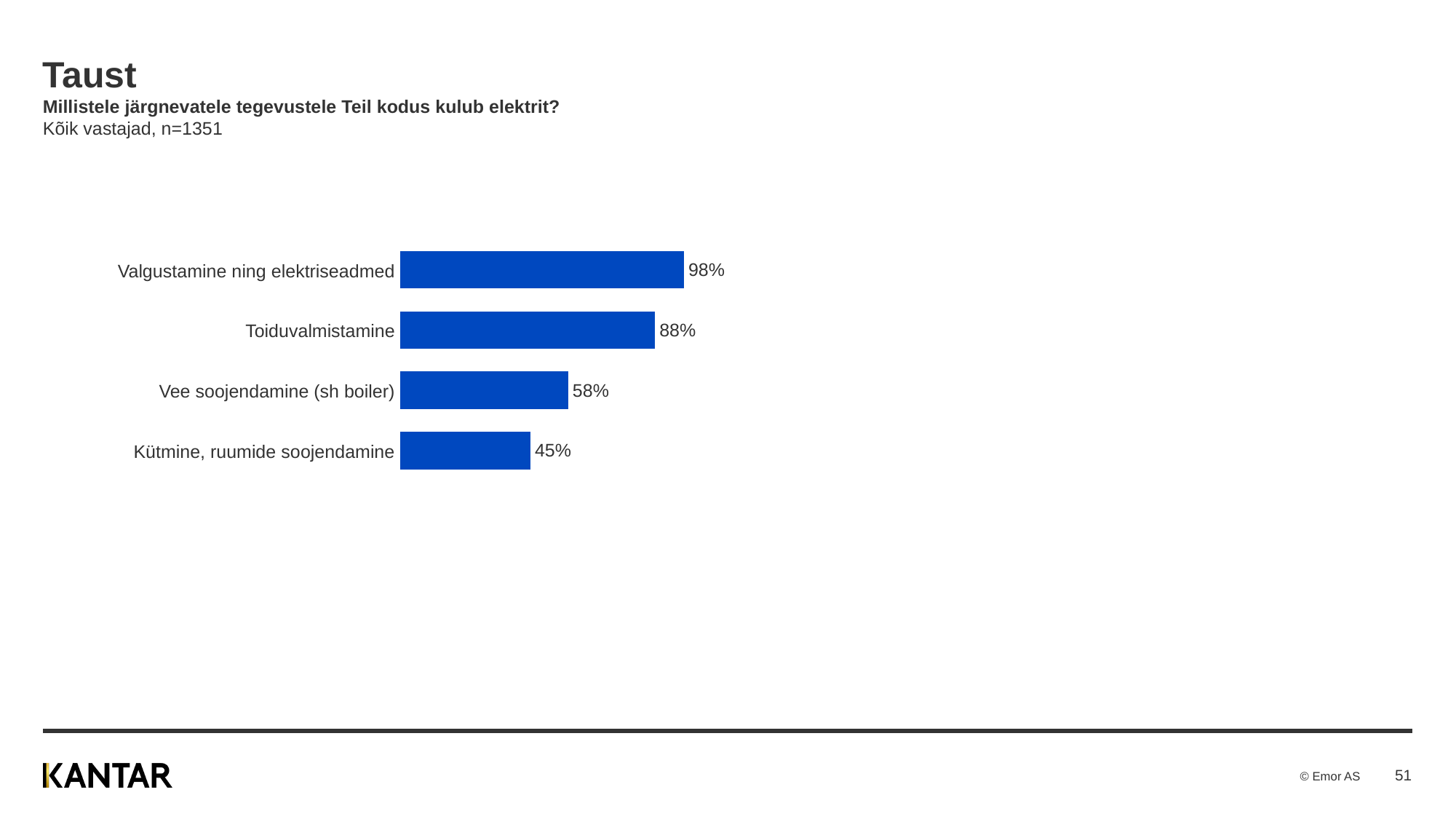
What is the difference between the values for Valgustamine ning elektriseadmed and Toiduvalmistamine? 10% What is the sample size (n) stated on the slide? n=1351 What is the difference between the values for Vee soojendamine (sh boiler) and Kütmine, ruumide soojendamine? 13% Which category has the highest value? Valgustamine ning elektriseadmed What is the value for Toiduvalmistamine? 88% What is the value for Valgustamine ning elektriseadmed? 98% What is the value for Kütmine, ruumide soojendamine? 45% How many categories are shown in the chart? 4 Which is larger, the value for Toiduvalmistamine or the value for Vee soojendamine (sh boiler)? Toiduvalmistamine What is the value for Vee soojendamine (sh boiler)? 58% What kind of chart is shown on the slide? Bar chart Which category has the lowest value? Kütmine, ruumide soojendamine